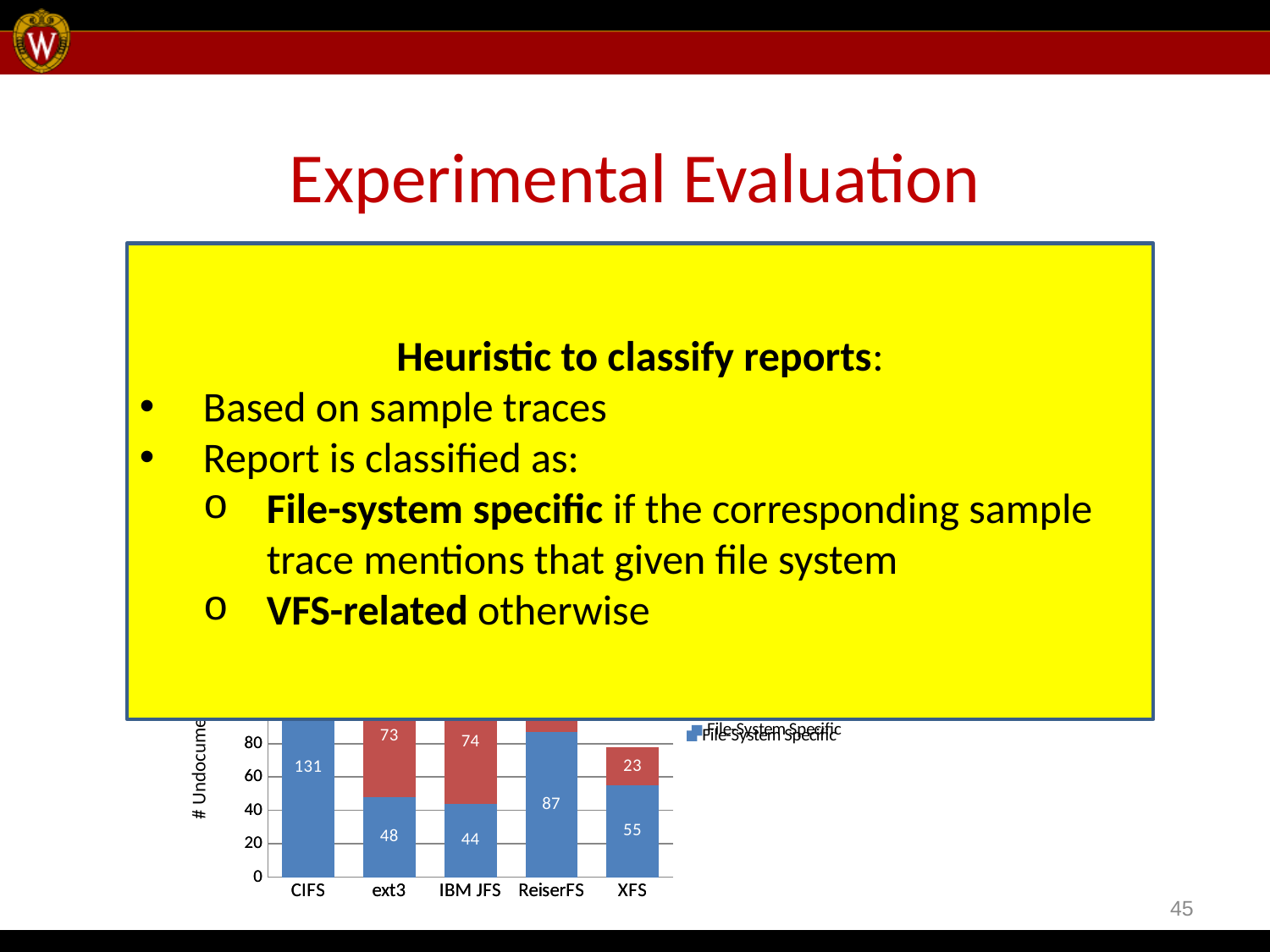
How many file systems (categories) are shown on the x axis of the chart? 5 What is the File-System Specific value for ext3? 48 What is the File-System Specific value for IBM JFS? 44 Which file system has the highest File-System Specific value? CIFS Which file system has the lowest File-System Specific value? IBM JFS Which is larger, the File-System Specific value for ReiserFS or for XFS? ReiserFS What is the File-System Specific value for CIFS? 131 What is the File-System Specific value for ReiserFS? 87 What is the difference between the red segment (74) and the blue segment (44) for IBM JFS? 30 What is the value of the red (upper) segment for XFS? 23 What is the total of the stacked bar for ext3 (48 + 73)? 121 What type of chart is shown on the slide? bar chart